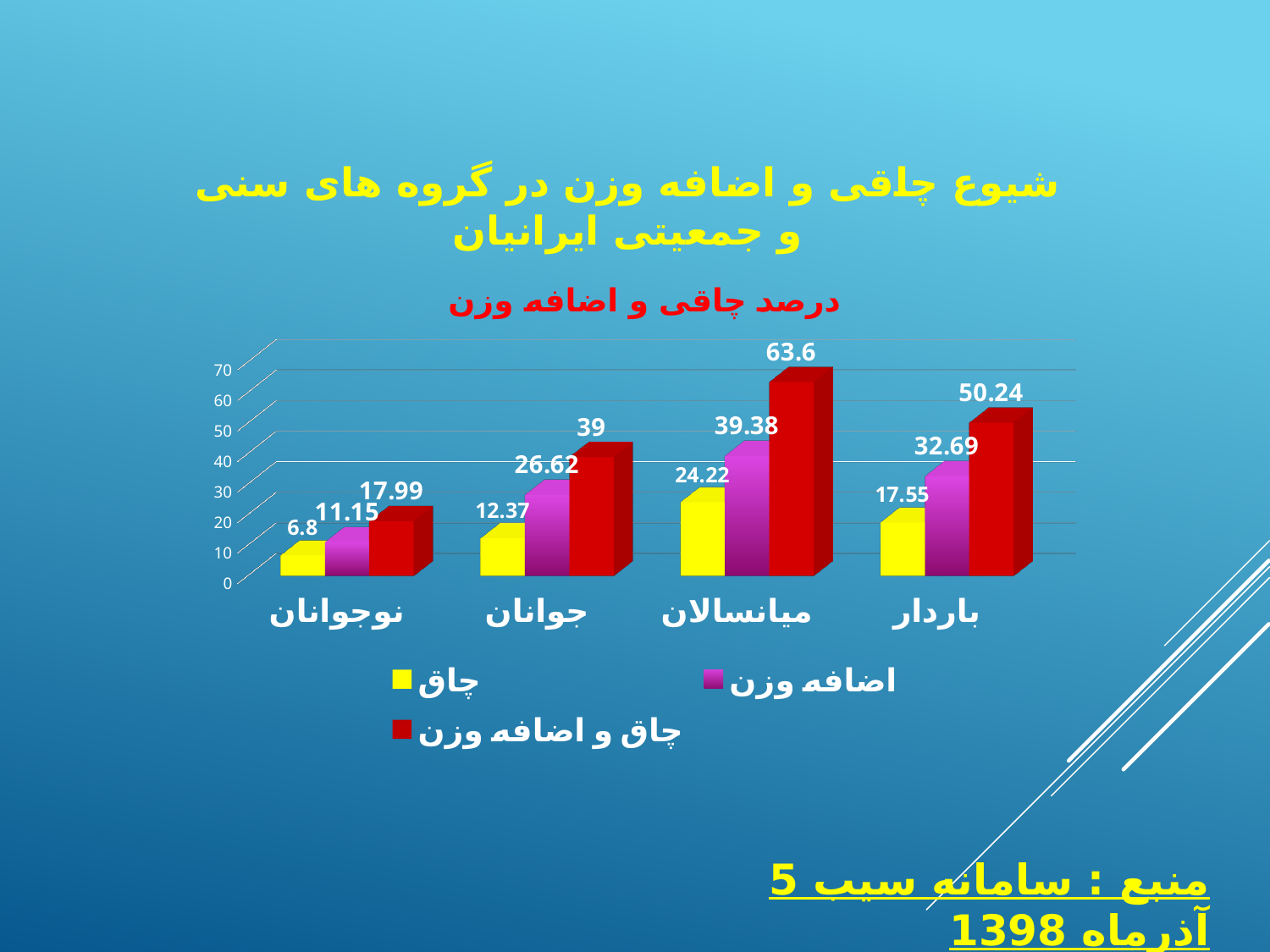
What is the value of the چاق series for نوجوانان? 6.8 What colour represents the چاق series in the chart? yellow What is the value of the چاق و اضافه وزن series for میانسالان? 63.6 What kind of chart is shown on the slide? bar chart What is the difference between the چاق و اضافه وزن values for میانسالان and باردار? 13.36 Which is larger: the چاق value for باردار or the چاق value for جوانان? باردار How many categories are shown on the x axis? 4 Which category has the lowest value for the چاق series? نوجوانان Which category has the highest value for the چاق و اضافه وزن series? میانسالان What is the value of the اضافه وزن series for باردار? 32.69 How many series does the legend list? 3 What is the value of the اضافه وزن series for جوانان? 26.62